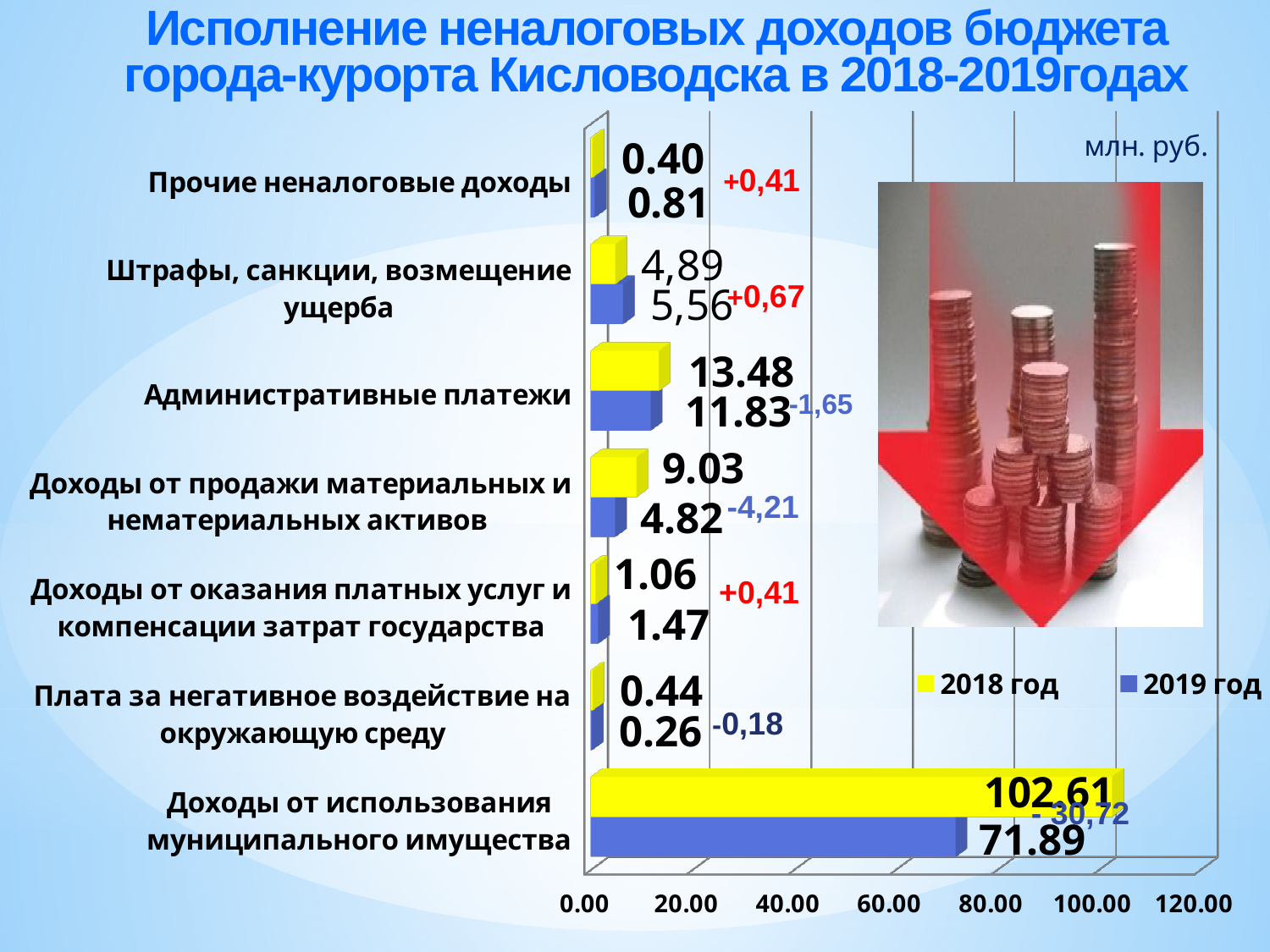
What is the difference between the 2018 год and 2019 год values for Доходы от использования муниципального имущества? 30.72 How many categories are shown on the chart? 7 How many series does the legend list? 2 Is the 2019 год value for Доходы от использования муниципального имущества greater or less than 80.00? less What is the 2019 год value for Доходы от использования муниципального имущества? 71.89 Which category has the highest 2018 год value? Доходы от использования муниципального имущества What is the 2018 год value for Доходы от продажи материальных и нематериальных активов? 9.03 Which is larger for Штрафы, санкции, возмещение ущерба: the 2018 год value or the 2019 год value? 2019 год What is the 2018 год value for Доходы от использования муниципального имущества? 102.61 What is the 2019 год value for Административные платежи? 11.83 What type of chart is shown on the slide? Bar chart Which category has the lowest 2019 год value? Плата за негативное воздействие на окружающую среду